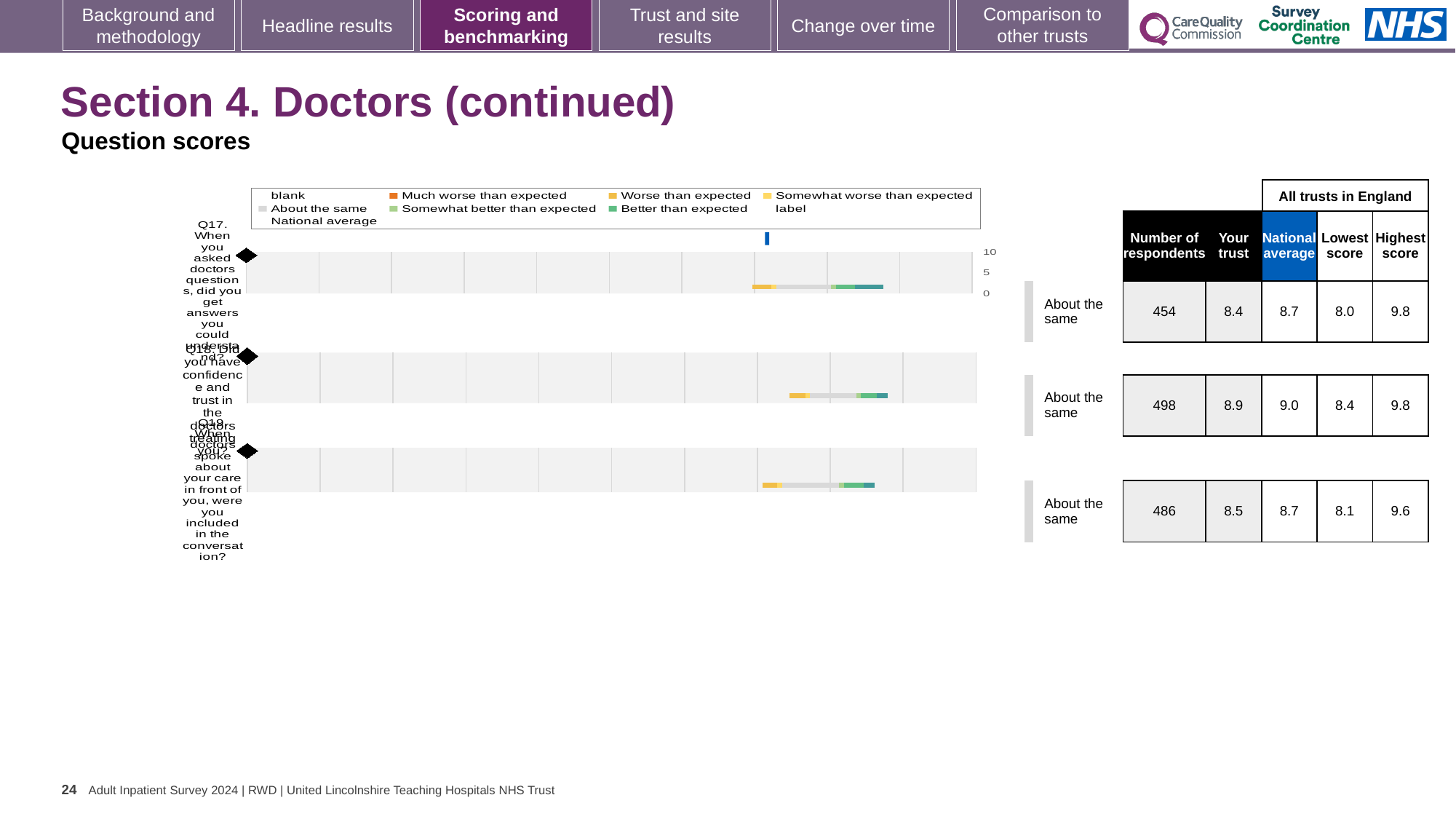
What is the difference between the national average and the 'Your trust' score for Q18? 0.1 What kind of chart is shown on the slide? bar chart In the table next to the chart, what is the number of respondents for Q17? 454 In the table next to the chart, what is the highest score for Q19? 9.6 What is the maximum value shown on the chart's axis? 10 In the table next to the chart, what is the 'Your trust' score for Q18? 8.9 How many questions (bars) are plotted in the chart? 3 Which question has the lowest 'Your trust' score in the table? Q17 What colour represents 'Much worse than expected' in the chart legend? orange How many entries does the chart legend list? 9 For Q19, which is larger: the 'Your trust' score or the national average? National average Which question has the highest 'Your trust' score in the table? Q18